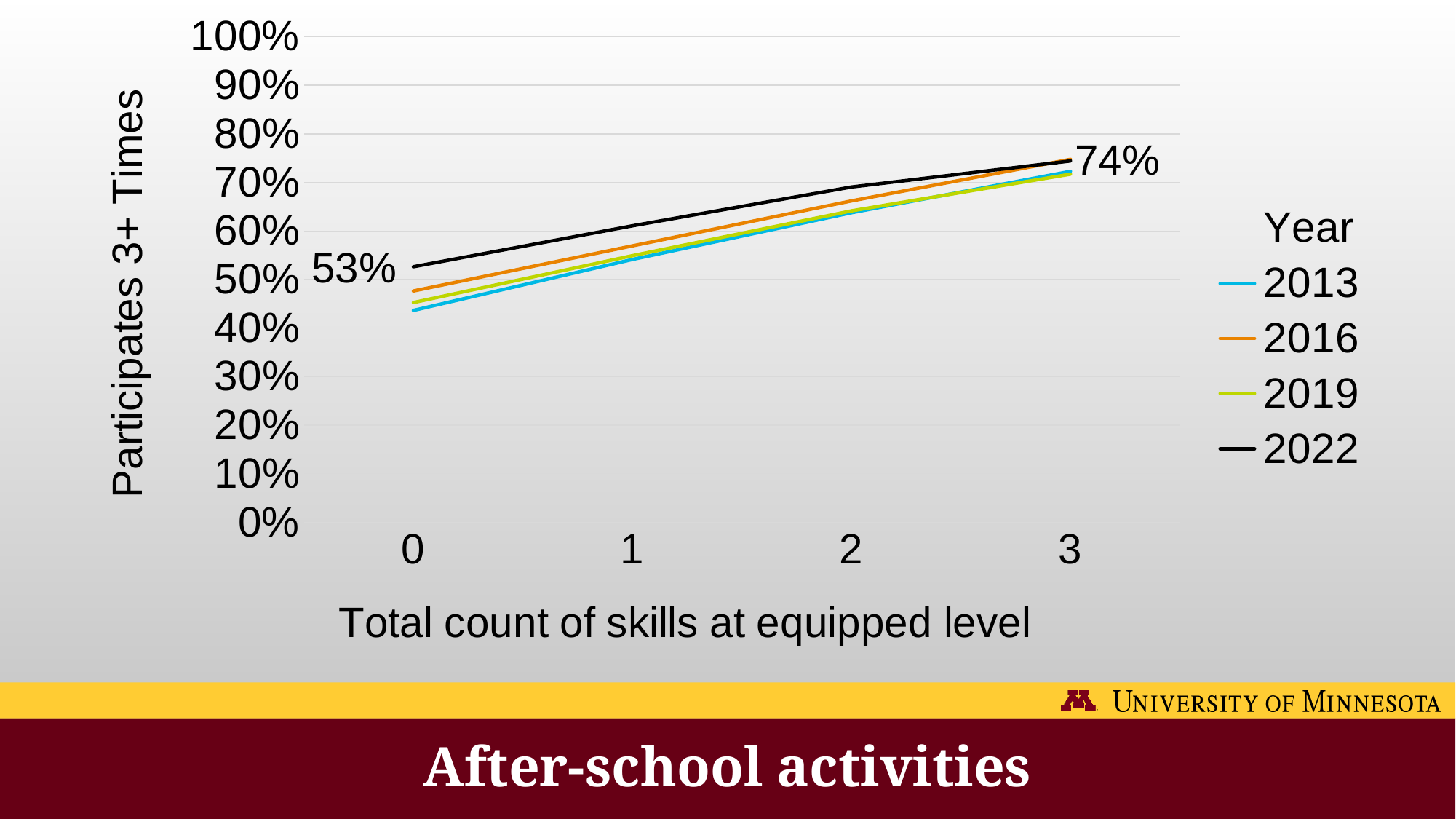
At 0 skills at equipped level, which is larger: the 2022 value or the 2013 value? 2022 Is the value for the 2013 series at 0 skills greater or less than 50%? less What is the value for the 2022 series at 0 skills at equipped level? 53% What kind of chart is shown on the slide? Line chart How many series does the legend list? 4 What is the title of the legend? Year Is the value for the 2013 series at 3 skills greater or less than 70%? greater At 0 skills at equipped level, which series has the highest value? 2022 Do the values rise or fall as the total count of skills at equipped level increases? Rise How many points are on the x axis (total count of skills at equipped level)? 4 By how many percentage points does the 2022 series rise from 0 to 3 skills at equipped level? 21 percentage points What is the value for the 2022 series at 3 skills at equipped level? 74%